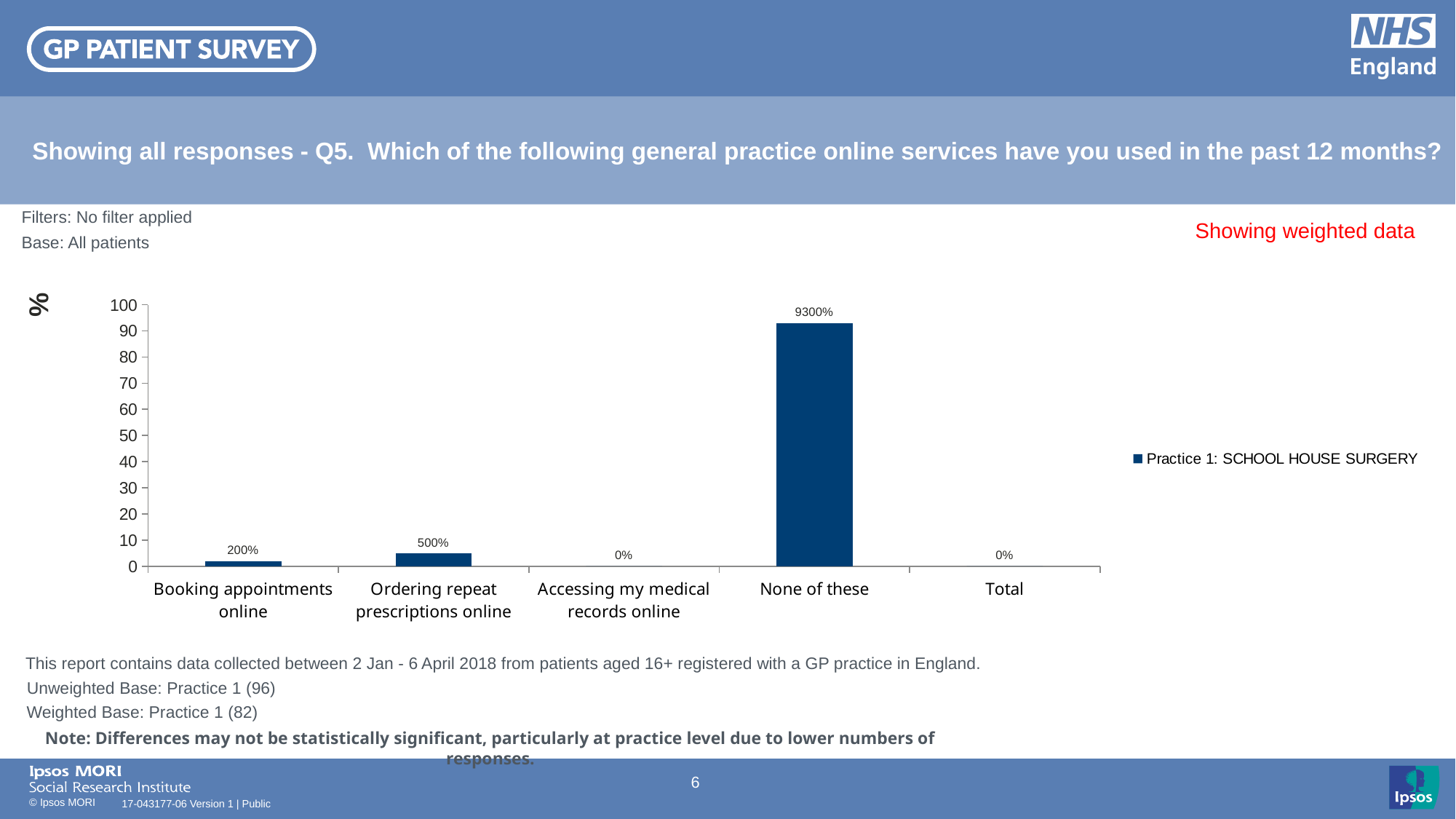
How many series does the legend list? 1 Which is larger, the value for 'Ordering repeat prescriptions online' or for 'Booking appointments online'? Ordering repeat prescriptions online Which category has the highest bar? None of these What is the name of the series shown in the legend? Practice 1: SCHOOL HOUSE SURGERY What is the data label shown for 'Booking appointments online'? 200% What is the data label shown for 'Accessing my medical records online'? 0% What kind of chart is shown on the slide? Bar chart How many categories are shown on the x axis? 5 Is the bar for 'Booking appointments online' greater or less than 10 on the axis? less What is the data label shown for 'None of these'? 9300% Is the bar for 'None of these' greater or less than 90 on the axis? greater What is the data label shown for 'Ordering repeat prescriptions online'? 500%